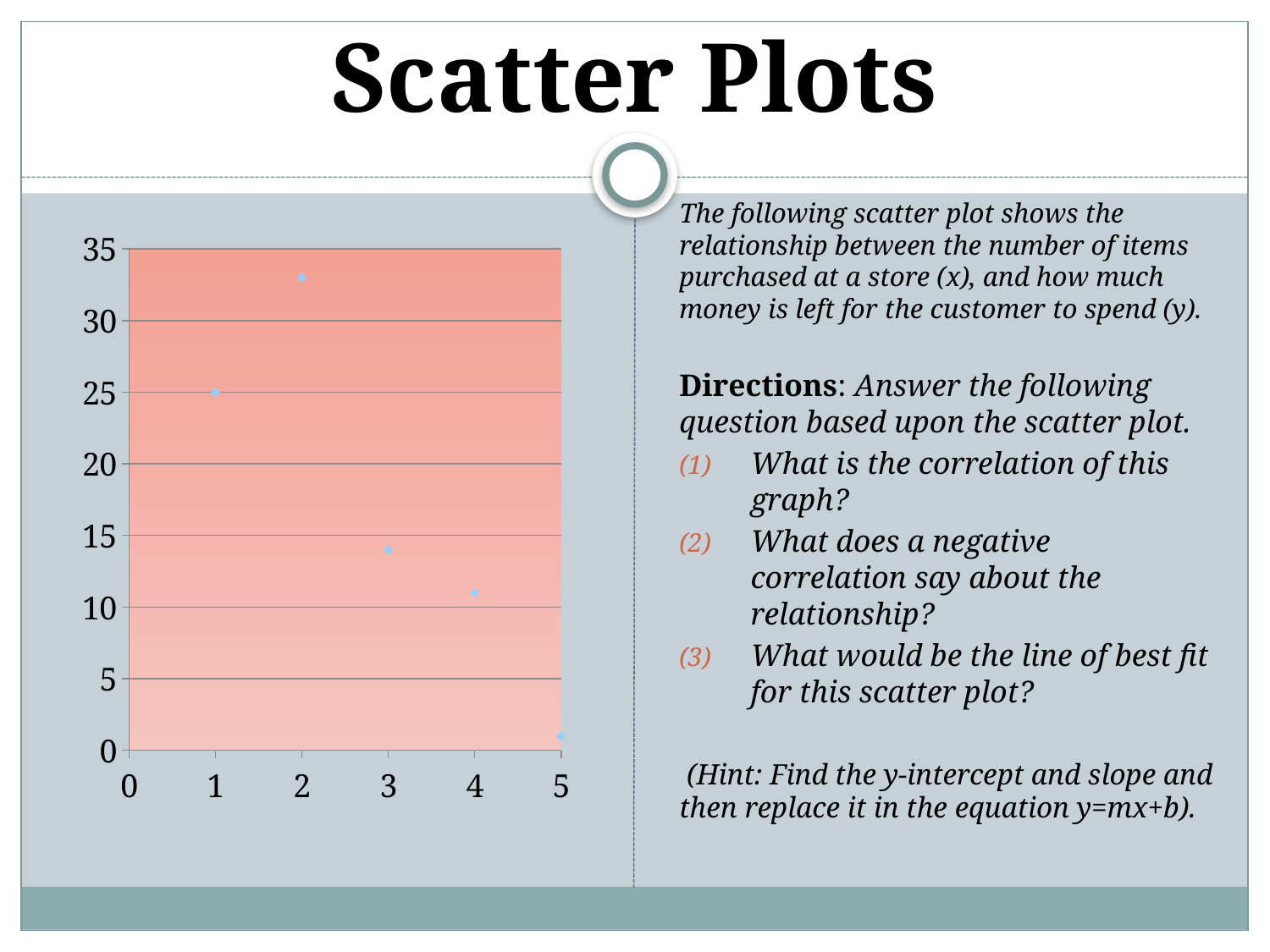
Do the y values generally rise or fall as x increases along the x axis? fall What kind of chart is shown on the slide? scatter plot How many data points are plotted on the scatter plot? 5 Is the y value of the point at x = 3 greater or less than 15? less What is the y value of the point at x = 1? 25 At which x value does the scatter plot have its highest point? 2 At which x value does the scatter plot have its lowest point? 5 Which point has a larger y value, the one at x = 1 or the one at x = 3? x = 1 Is the y value of the point at x = 5 greater or less than 5? less What is the highest value shown on the x axis? 5 What is the highest value shown on the y axis? 35 Is the y value of the point at x = 2 greater or less than 30? greater